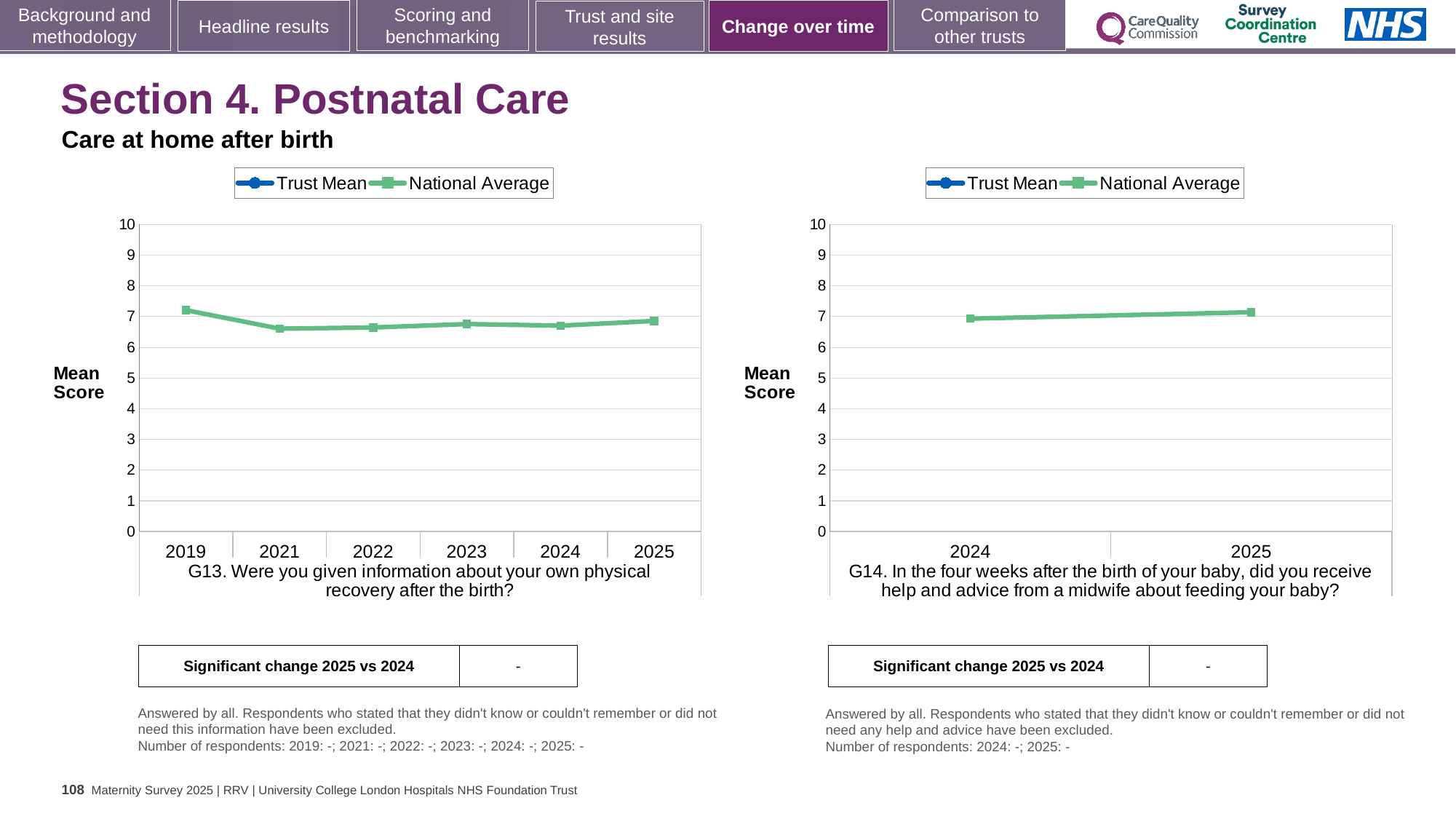
What is the label on the y axis of the left chart (G13)? Mean Score In the left chart (G13), is the National Average value for 2021 greater or less than 7? less What are the two legend entries on the right chart (G14)? Trust Mean, National Average In the left chart (G13), is the National Average value for 2019 greater or less than 7? greater In the right chart (G14), is the National Average value for 2024 greater or less than 6? greater In the left chart (G13), does the National Average line rise or fall from 2019 to 2021? fall What kind of chart is the left chart (G13)? line chart In the right chart (G14), does the National Average line rise or fall from 2024 to 2025? rise How many years are shown on the x axis of the right chart (G14)? 2 In the left chart (G13), which year has the highest National Average value? 2019 How many years are shown on the x axis of the left chart (G13)? 6 How many series does the legend of the left chart (G13) list? 2